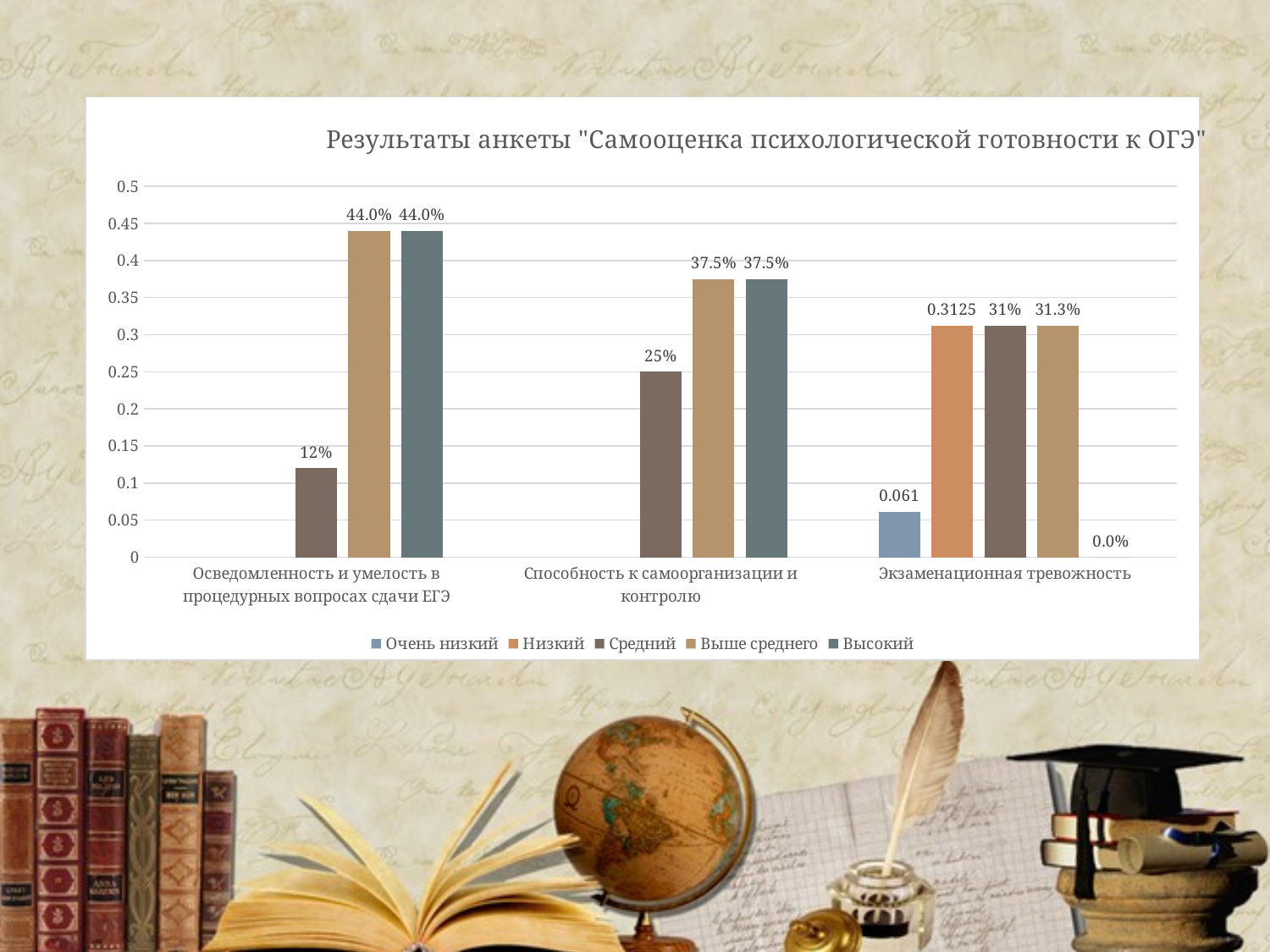
What is the value of the "Средний" series for "Осведомленность и умелость в процедурных вопросах сдачи ЕГЭ"? 12% What is the value of the "Высокий" series for "Экзаменационная тревожность"? 0.0% Is the "Средний" value for "Способность к самоорганизации и контролю" greater or less than 0.3? less What is the value of the "Очень низкий" series for "Экзаменационная тревожность"? 0.061 How many series does the legend list? 5 What kind of chart is shown on the slide? bar chart Which is larger for "Осведомленность и умелость в процедурных вопросах сдачи ЕГЭ": the "Средний" value or the "Выше среднего" value? Выше среднего Which series has the lowest value for "Способность к самоорганизации и контролю"? Средний What is the value of the "Низкий" series for "Экзаменационная тревожность"? 0.3125 What is the value of the "Высокий" series for "Способность к самоорганизации и контролю"? 37.5% How many categories are shown on the x axis? 3 What is the title of the chart? Результаты анкеты "Самооценка психологической готовности к ОГЭ"